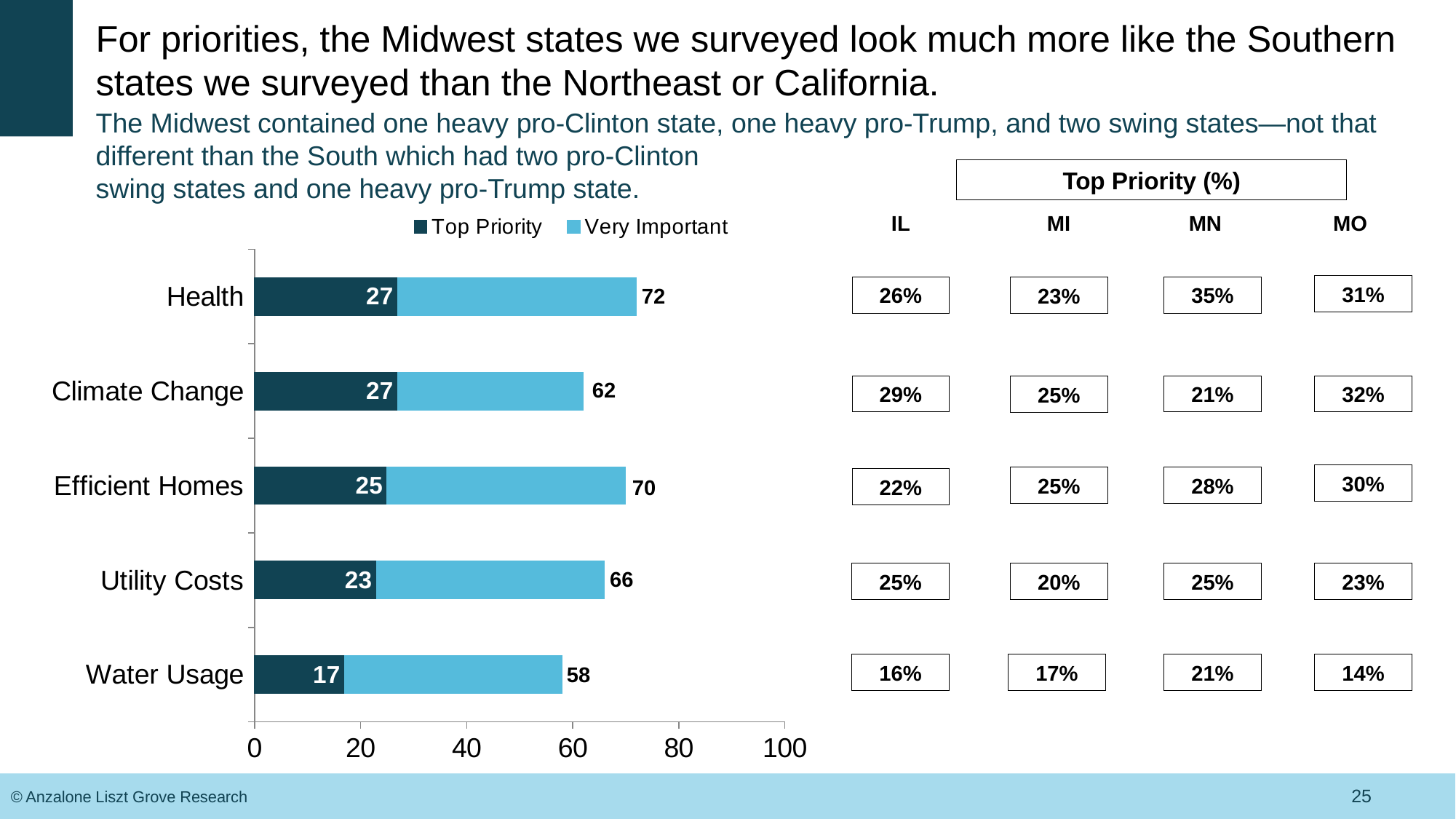
What is the total of the stacked bar for Climate Change? 62 What is the Top Priority value for Water Usage? 17 Is the Very Important segment for Climate Change greater or less than 40? less What is the total of the stacked bar for Health? 72 How many categories are shown in the chart? 5 Which category has the lowest Top Priority value? Water Usage Which has the larger total bar, Climate Change or Efficient Homes? Efficient Homes What is the Top Priority value for Health? 27 Which category has the highest total bar? Health What kind of chart is shown on the slide? Stacked bar chart How many series does the legend list? 2 What is the difference between the total bar for Health and the total bar for Water Usage? 14